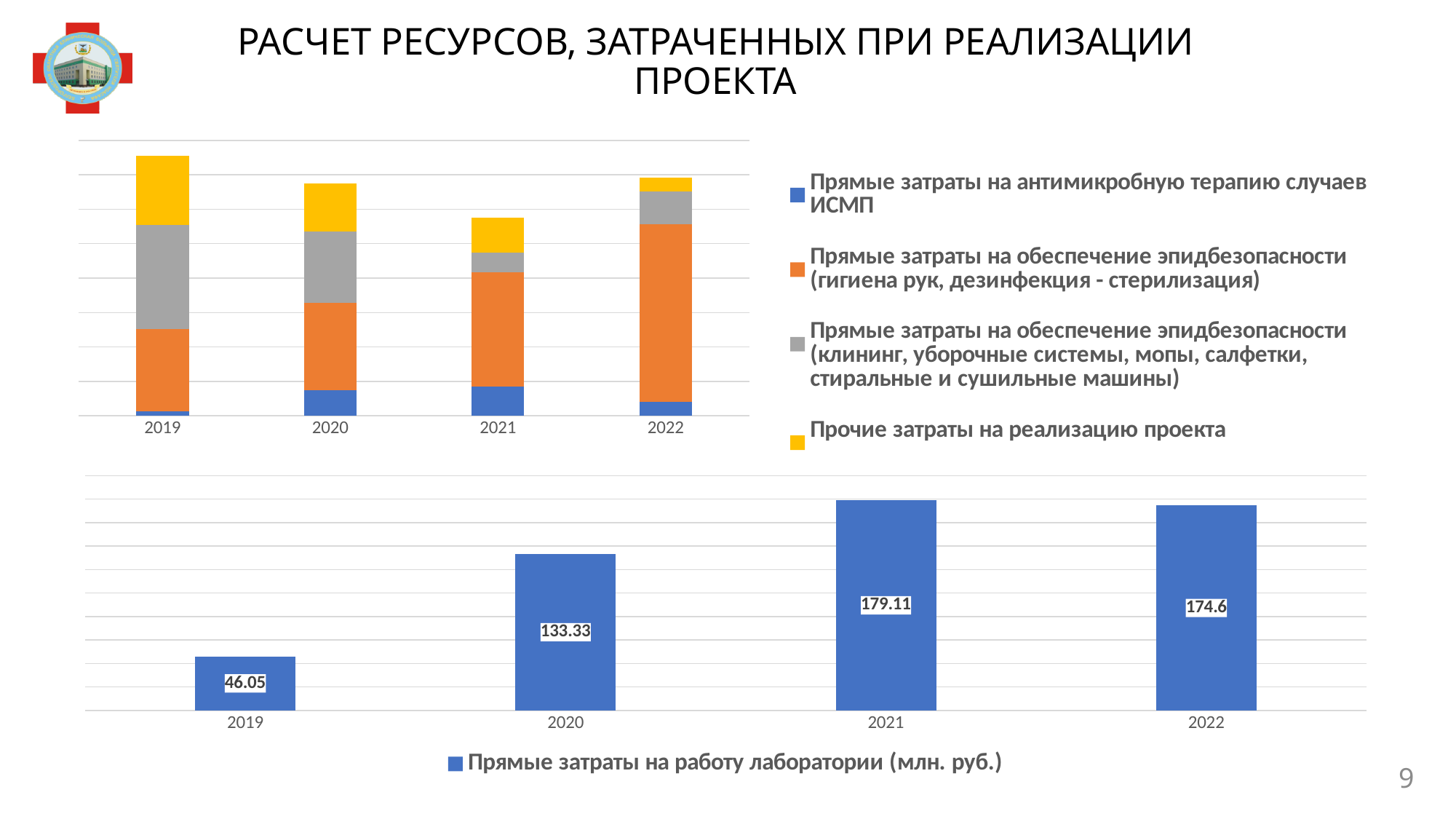
In the bottom chart (Прямые затраты на работу лаборатории), what is the value for 2020? 133.33 In the bottom chart (Прямые затраты на работу лаборатории), which year has the lowest value? 2019 In the bottom chart (Прямые затраты на работу лаборатории), what is the difference between the values for 2021 and 2022? 4.51 In the bottom chart (Прямые затраты на работу лаборатории), what is the difference between the values for 2021 and 2019? 133.06 What kind of chart is the top chart on the slide? stacked bar chart How many series does the legend of the top stacked chart list? 4 In the bottom chart (Прямые затраты на работу лаборатории), do the values rise or fall from 2019 to 2021? rise In the bottom chart (Прямые затраты на работу лаборатории), what is the value for 2022? 174.6 How many years are shown on the x axis of the top stacked chart? 4 In the bottom chart (Прямые затраты на работу лаборатории), which year has the highest value? 2021 In the bottom chart (Прямые затраты на работу лаборатории), which is larger, the value for 2020 or the value for 2022? 2022 In the top stacked chart, which year has the shortest total bar? 2021